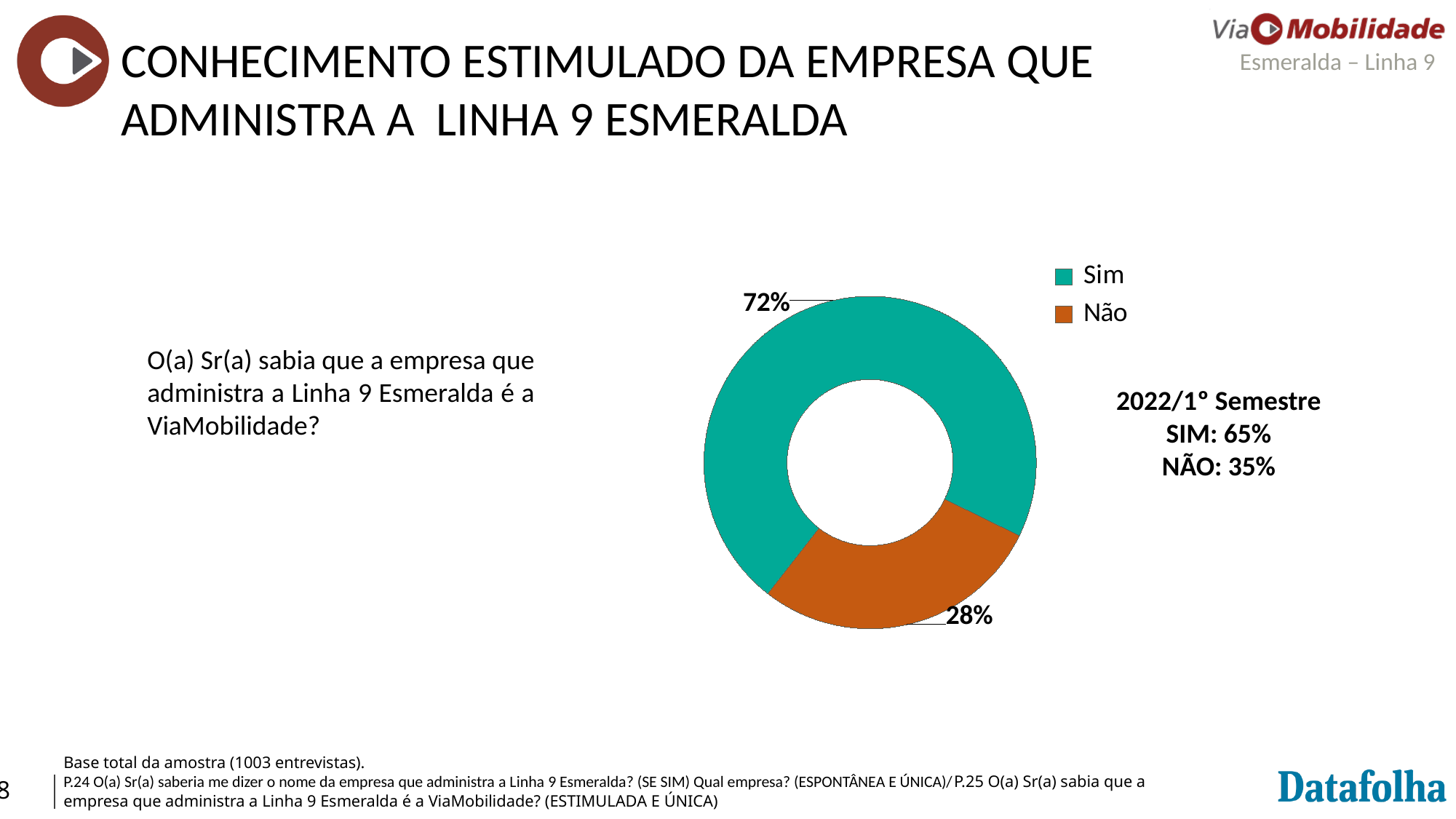
What share of the pie does the "Sim" slice represent? 72% How many entries does the chart legend list? 2 Which is larger in the pie chart, "Sim" or "Não"? Sim What percentage of the pie chart is labelled "Sim"? 72% What kind of chart is shown on the slide? Pie chart (doughnut) According to the text beside the chart, what was the "SIM" percentage in 2022/1° Semestre? 65% Which slice of the pie chart is the smallest? Não Which slice of the pie chart is the largest? Sim What is the difference in percentage points between the "Sim" and "Não" slices? 44 What percentage of the pie chart is labelled "Não"? 28% What colour is the "Não" slice in the pie chart? Orange/brown How many slices does the pie chart have? 2